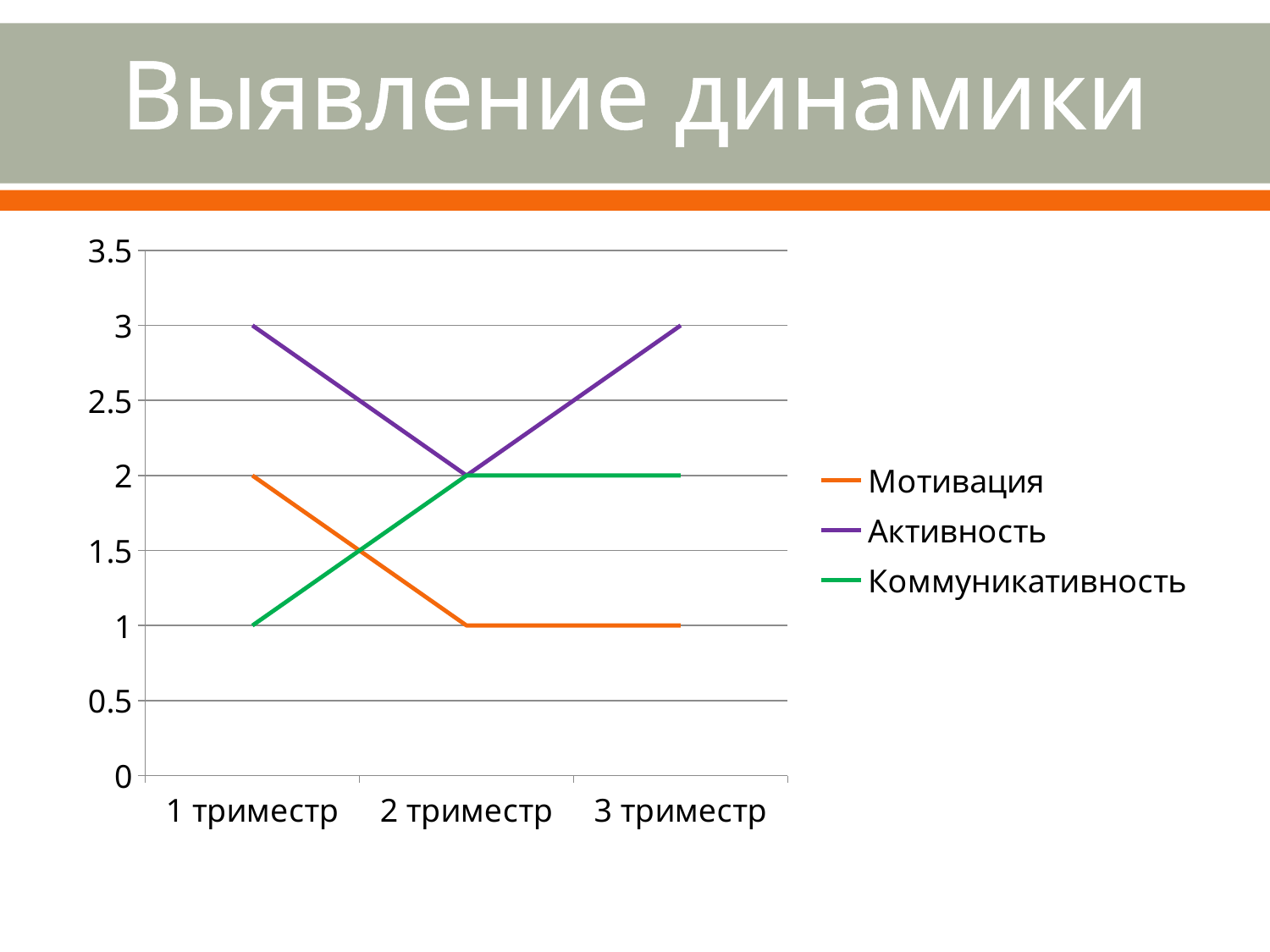
Which series has the highest value in 3 триместр? Активность What is the difference between Активность and Мотивация in 1 триместр? 1 Which colour is used for the Коммуникативность series? green What is the value of Коммуникативность in 1 триместр? 1 What is the value of Мотивация in 2 триместр? 1 What is the value of Коммуникативность in 3 триместр? 2 How many points are on the x axis of the chart? 3 What is the value of Активность in 1 триместр? 3 What kind of chart is shown on the slide? line chart Does the Мотивация series rise or fall from 1 триместр to 2 триместр? fall Which series has the lowest value in 1 триместр? Коммуникативность How many series does the legend list? 3